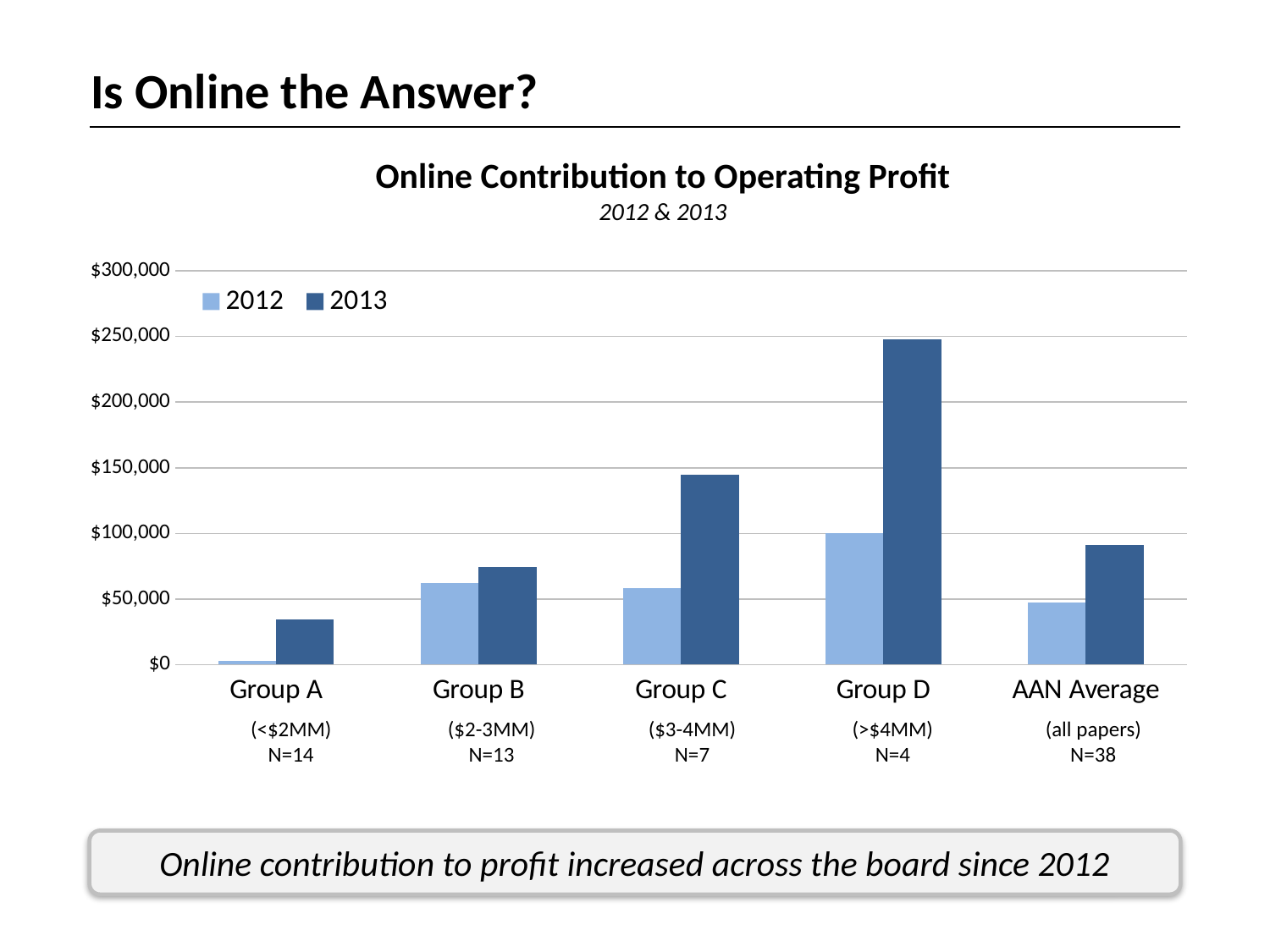
What is the title of the chart? Online Contribution to Operating Profit How many series does the legend list? 2 Is the 2013 value for Group C greater or less than $100,000? greater Do the 2013 values rise or fall from Group A to Group D? rise Which is larger, the 2013 value for Group B or the 2013 value for Group C? Group C Is the 2013 value for Group A greater or less than $50,000? less Is the 2013 value for Group D greater or less than $200,000? greater How many categories are shown on the x axis? 5 Which category has the highest 2013 value? Group D Which category has the lowest 2012 value? Group A What kind of chart is shown on the slide? bar chart